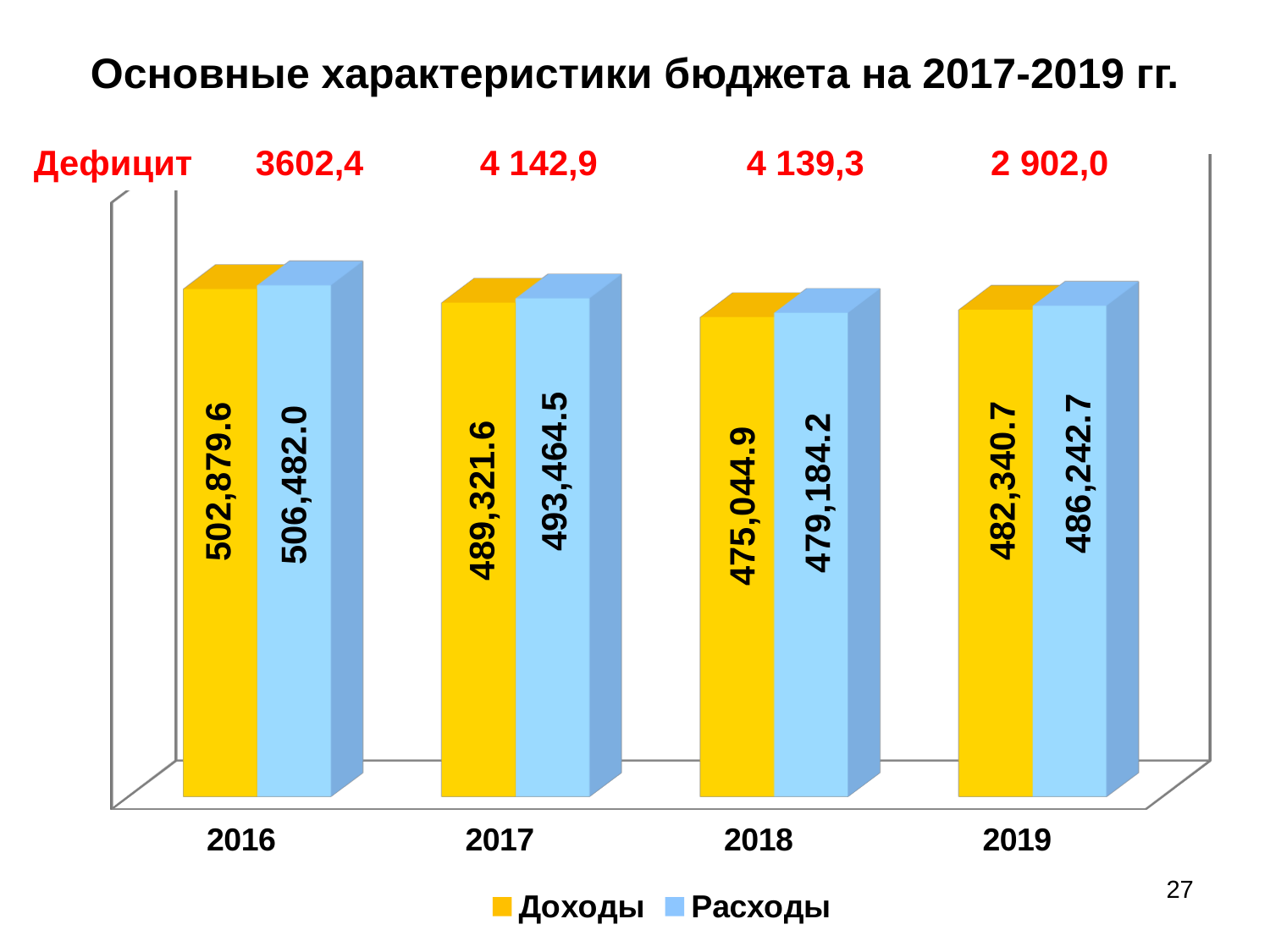
What kind of chart is shown on the slide? Bar chart In which year is Расходы the lowest? 2018 What is the value of Расходы for 2017? 493,464.5 Which is larger in 2018, Доходы or Расходы? Расходы What is the value of Доходы for 2016? 502,879.6 How many years are shown on the x axis? 4 What is the value of Доходы for 2018? 475,044.9 Do the Доходы values rise or fall from 2016 to 2018? Fall How many series does the legend list? 2 What is the difference between Расходы and Доходы in 2017? 4,142.9 In which year is Доходы the highest? 2016 What is the value of Расходы for 2019? 486,242.7